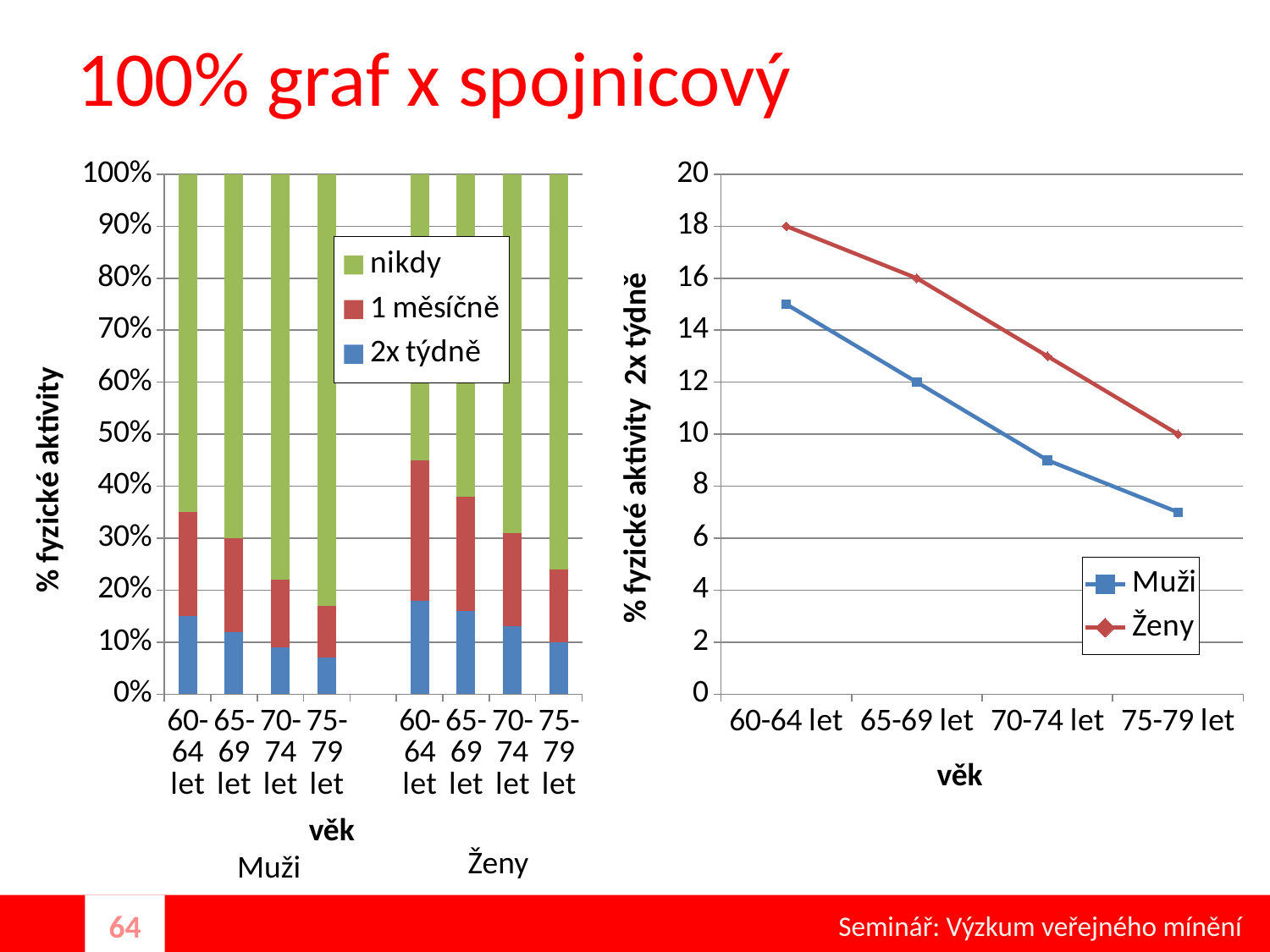
In the line chart on the right, is the value for Muži at 75-79 let greater or less than 8? less How many series does the legend of the stacked bar chart on the left list? 3 How many series does the legend of the line chart on the right list? 2 In the line chart on the right, what is the difference between Ženy at 60-64 let and Ženy at 75-79 let? 8 In the line chart on the right, what is the value for Ženy at 60-64 let? 18 In the line chart on the right, what is the value for Muži at 65-69 let? 12 What kind of chart is the chart on the right side of the slide? line chart In the stacked bar chart on the left, is the 'nikdy' segment for Muži 75-79 let greater or less than 70%? greater What kind of chart is the chart on the left side of the slide? bar chart In the line chart on the right, which series has the higher value at 70-74 let, Muži or Ženy? Ženy In the line chart on the right, what is the value for Ženy at 75-79 let? 10 In the line chart on the right, do the values for Muži rise or fall as age increases along the x axis? fall